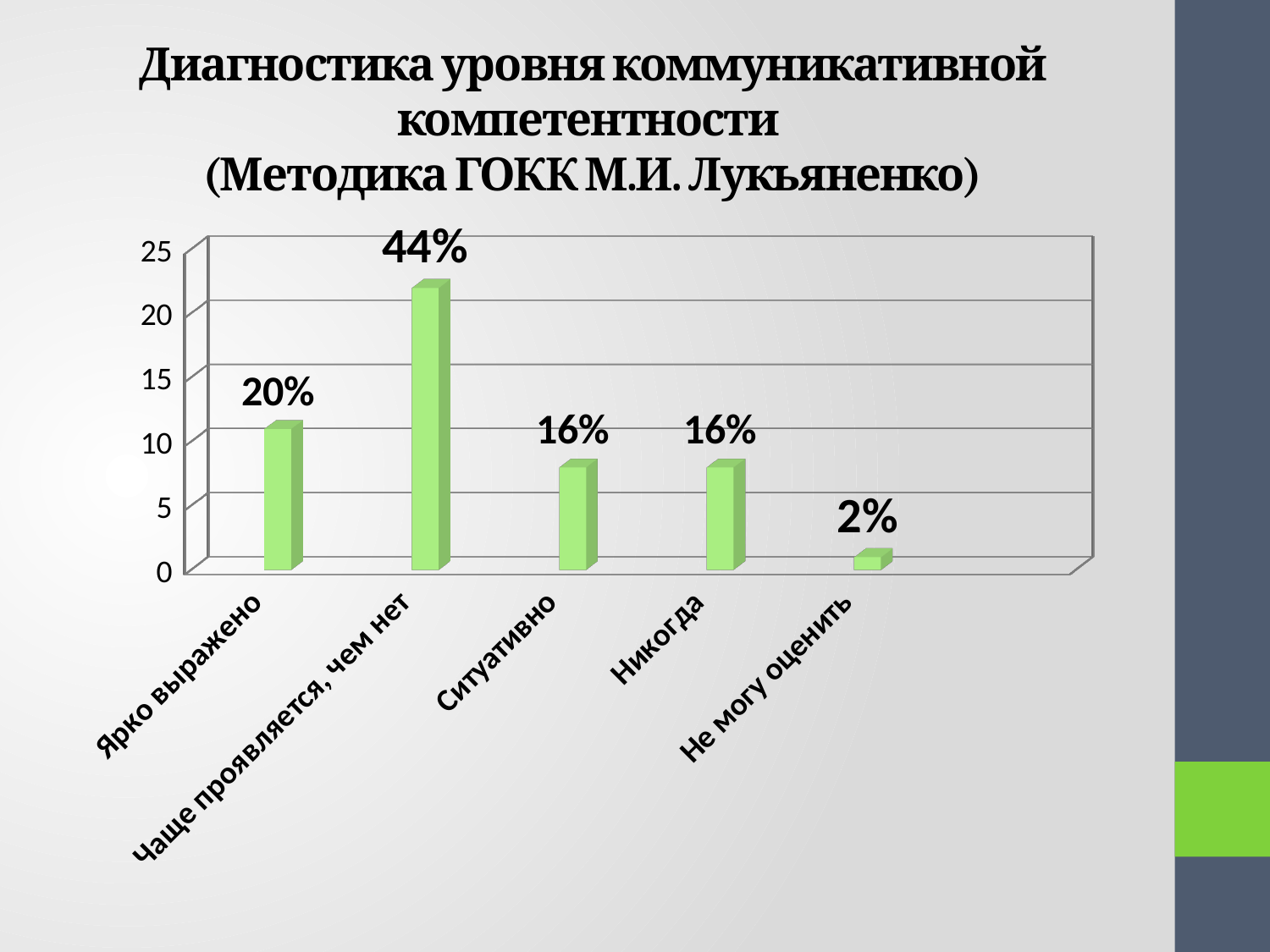
Is the bar for "Ситуативно" greater or less than 10 on the vertical axis? less What is the data label for the bar "Чаще проявляется, чем нет"? 44% What is the data label for the bar "Не могу оценить"? 2% How many categories are shown on the x axis? 5 What is the data label for the bar "Ярко выражено"? 20% What is the data label for the bar "Ситуативно"? 16% Which category has the lowest bar? Не могу оценить Which category has the highest bar? Чаще проявляется, чем нет Which is larger: the value for "Ярко выражено" or the value for "Ситуативно"? Ярко выражено Is the bar for "Чаще проявляется, чем нет" greater or less than 20 on the vertical axis? greater What kind of chart is shown on the slide? bar chart What is the difference between the data labels for "Чаще проявляется, чем нет" and "Ярко выражено"? 24%